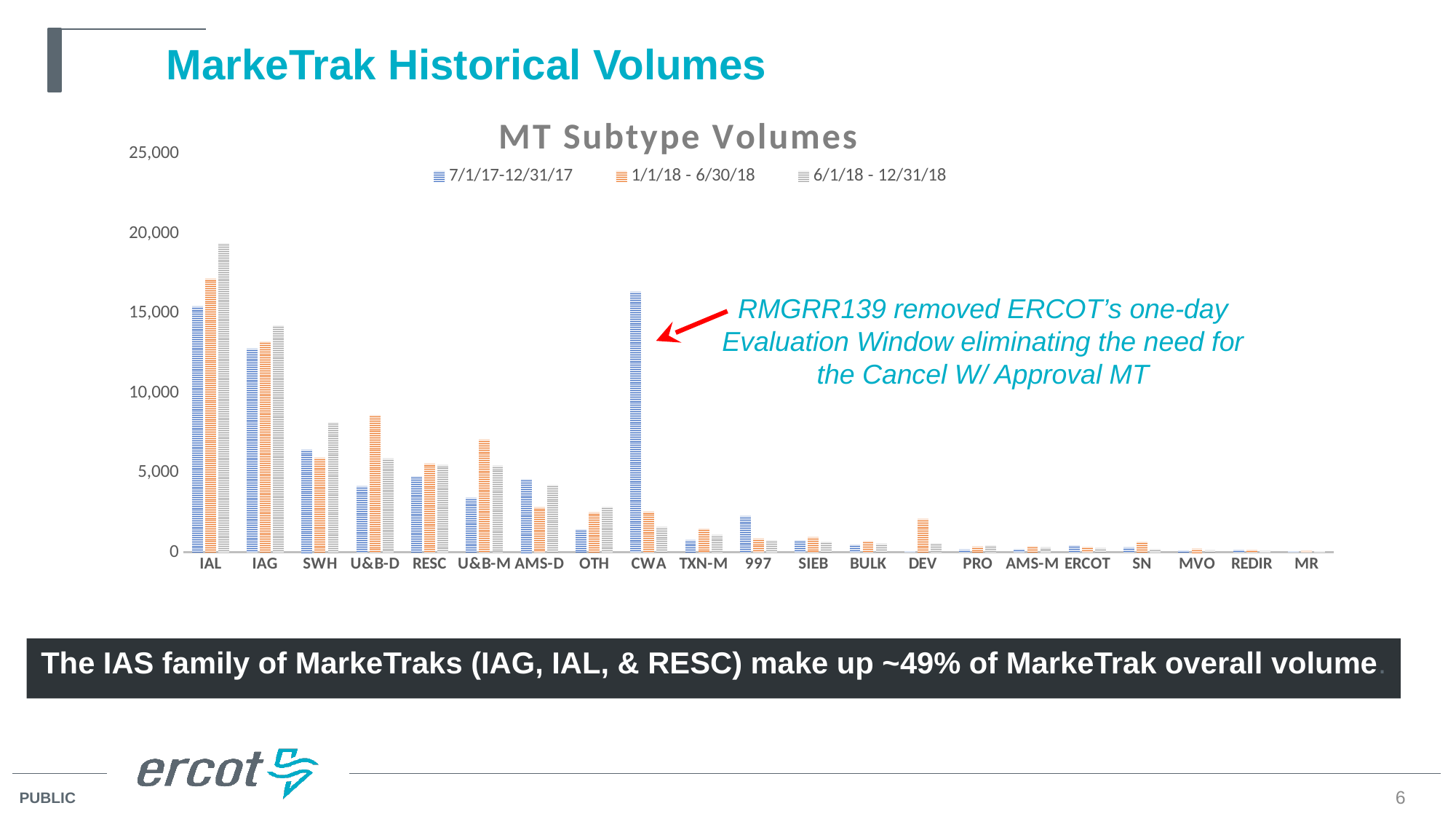
Is the 7/1/17-12/31/17 value for CWA greater or less than 15,000? greater Is the 6/1/18 - 12/31/18 value for OTH greater or less than 5,000? less How many categories are shown along the x axis of the chart? 21 Which category has the tallest bar for the 7/1/17-12/31/17 series? CWA For the 6/1/18 - 12/31/18 series, which is larger: IAL or IAG? IAL How many series does the chart's legend list? 3 Which category has the tallest bar in the chart? IAL What type of chart is shown on the slide? Bar chart What is the title of the chart? MT Subtype Volumes For CWA, which series has the larger value: 7/1/17-12/31/17 or 1/1/18 - 6/30/18? 7/1/17-12/31/17 Is the 1/1/18 - 6/30/18 value for U&B-D greater or less than 5,000? greater